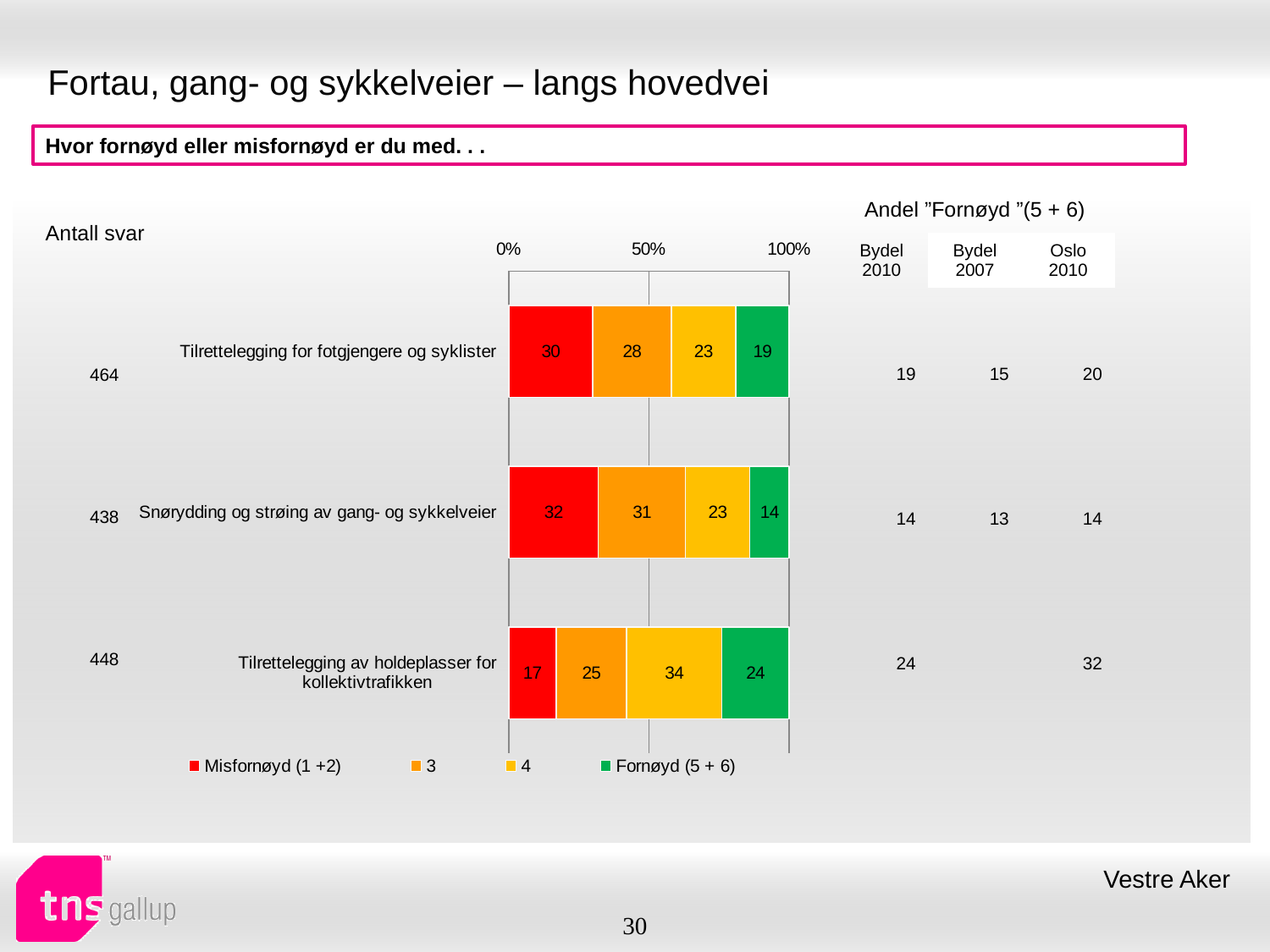
What is the total of the stacked bar for "Tilrettelegging for fotgjengere og syklister"? 100 Which is larger: the "3" value for "Snørydding og strøing av gang- og sykkelveier" or the "3" value for "Tilrettelegging av holdeplasser for kollektivtrafikken"? Snørydding og strøing av gang- og sykkelveier How many categories are plotted in the chart? 3 What is the difference between the "Fornøyd (5 + 6)" values for "Tilrettelegging av holdeplasser for kollektivtrafikken" and "Snørydding og strøing av gang- og sykkelveier"? 10 Which category has the lowest "Misfornøyd (1 +2)" value? Tilrettelegging av holdeplasser for kollektivtrafikken How many series does the chart legend list? 4 Which colour represents the "Fornøyd (5 + 6)" series in the chart? Green Which category has the highest "Fornøyd (5 + 6)" value? Tilrettelegging av holdeplasser for kollektivtrafikken What is the "Fornøyd (5 + 6)" value for "Tilrettelegging for fotgjengere og syklister"? 19 What kind of chart is shown on the slide? Stacked bar chart What is the "Misfornøyd (1 +2)" value for "Snørydding og strøing av gang- og sykkelveier"? 32 What is the value of series "4" for "Tilrettelegging av holdeplasser for kollektivtrafikken"? 34